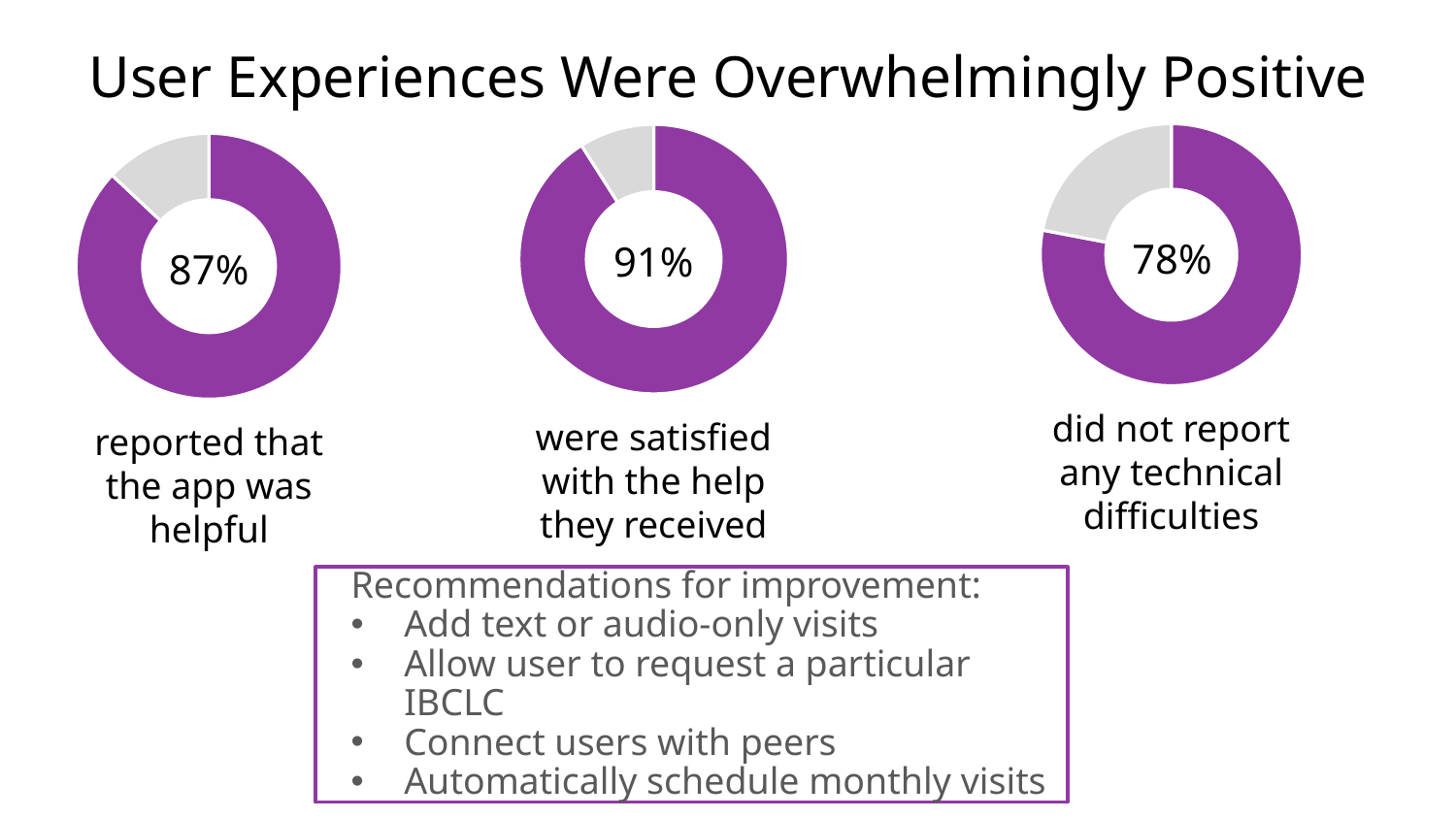
What is the title of the slide containing the three donut charts? User Experiences Were Overwhelmingly Positive What type of chart is used to display the percentages on the slide? Donut (pie) chart What is the difference between the percentage satisfied with the help they received and the percentage who did not report any technical difficulties? 13% What percentage of users did not report any technical difficulties, according to the right donut chart? 78% How many donut charts are shown on the slide? 3 In the right donut chart, what share of the ring is not filled in purple (the grey portion)? 22% What percentage of users reported that the app was helpful, according to the left donut chart? 87% Which of the three donut charts shows the highest percentage? were satisfied with the help they received (91%) Which is larger: the percentage who reported the app was helpful or the percentage satisfied with the help they received? satisfied with the help they received (91%) Which of the three donut charts shows the lowest percentage? did not report any technical difficulties (78%) What is the difference between the percentage who reported the app was helpful and the percentage who did not report any technical difficulties? 9% What percentage of users were satisfied with the help they received, according to the middle donut chart? 91%